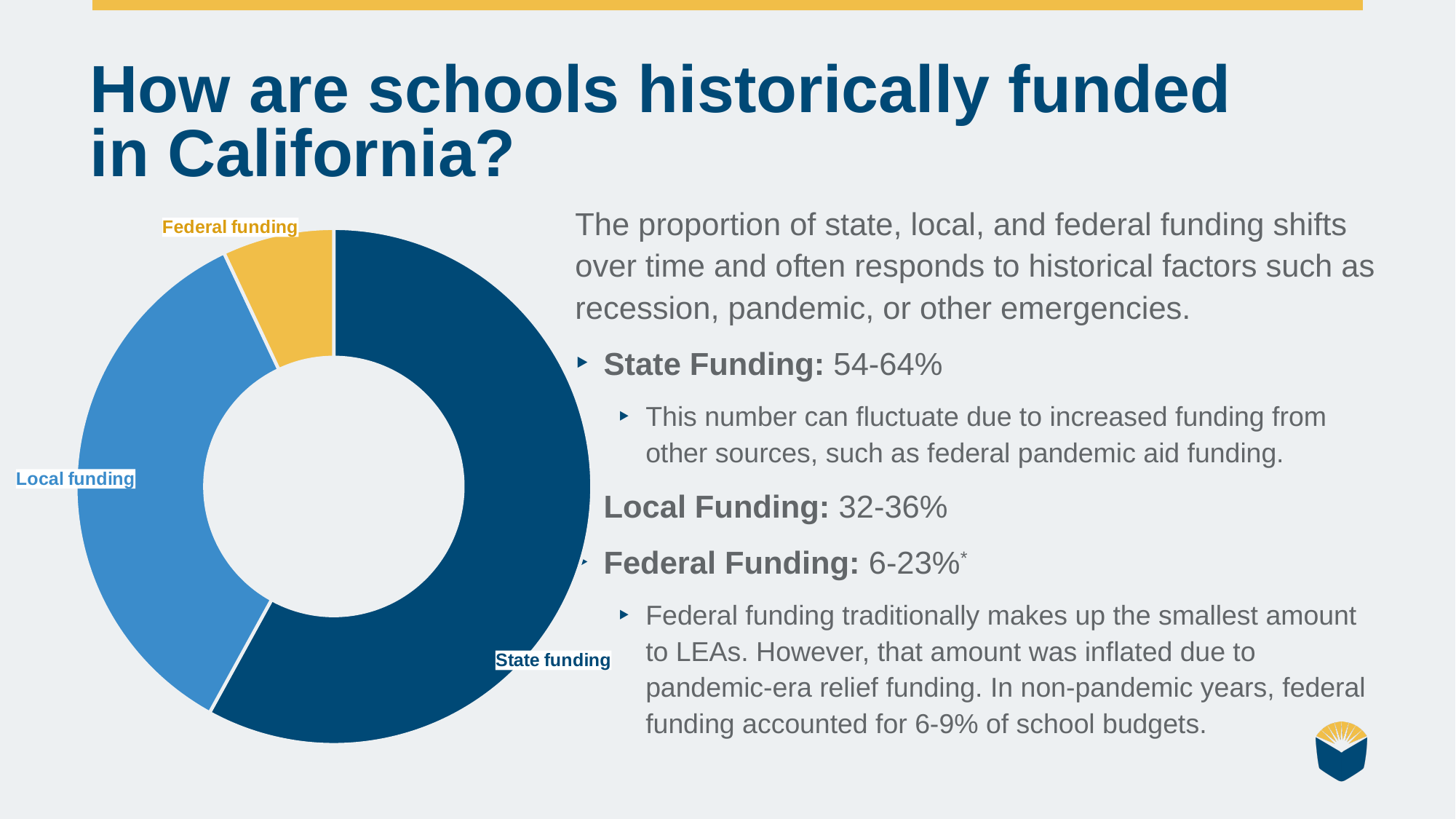
Which slice is larger, State funding or Local funding? State funding Which slice is larger, Local funding or Federal funding? Local funding Which slice is smaller, State funding or Federal funding? Federal funding Which funding source has the largest slice in the chart? State funding What kind of chart is shown on the slide? donut chart What colour is the State funding slice? dark blue What colour is the Federal funding slice? yellow Which funding source has the smallest slice in the chart? Federal funding How many slices does the chart have? 3